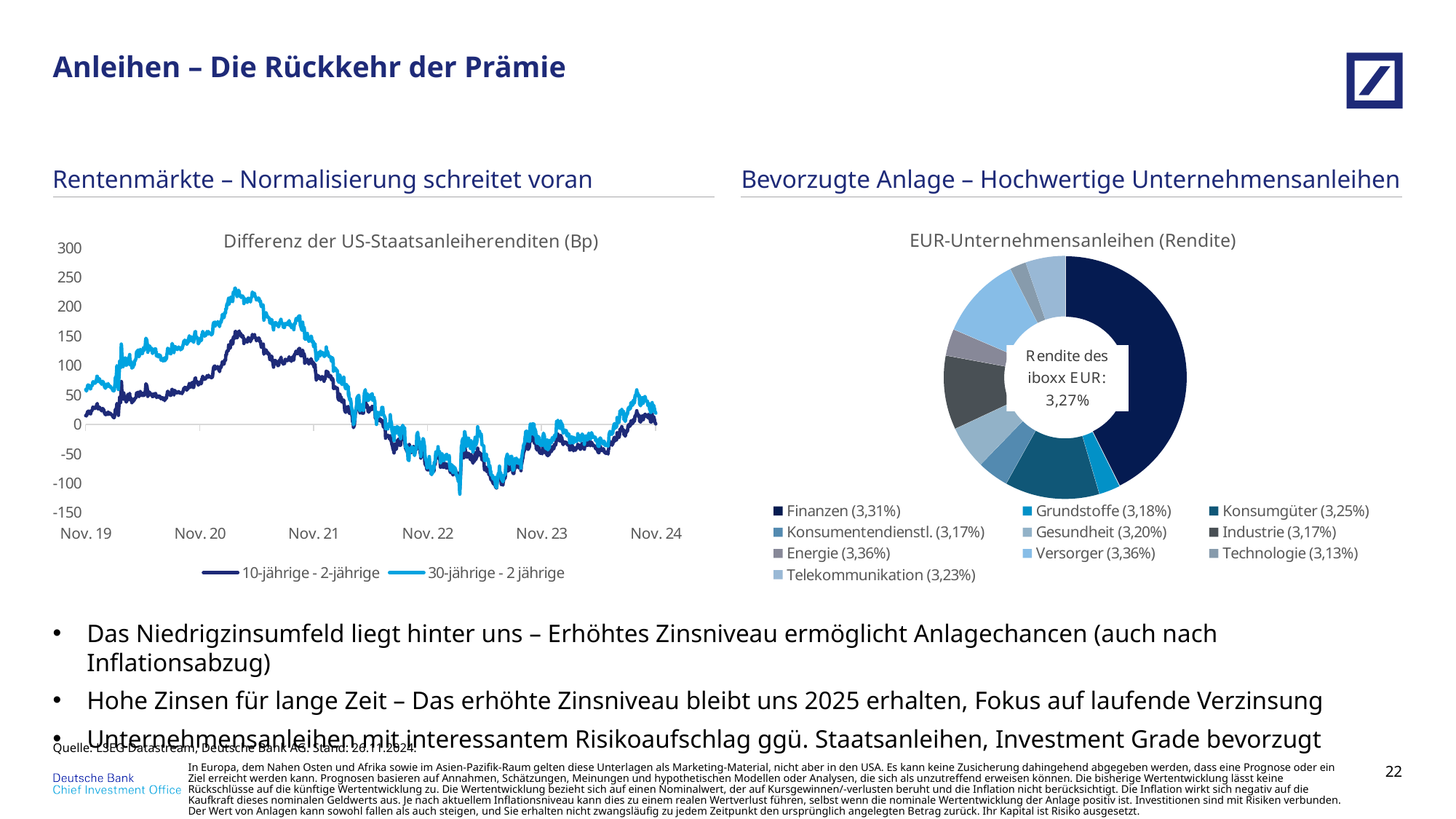
In the right chart 'EUR-Unternehmensanleihen (Rendite)', what is the yield shown for Finanzen? 3,31% In the right chart 'EUR-Unternehmensanleihen (Rendite)', what is the 'Rendite des iboxx EUR' shown in the centre of the doughnut? 3,27% In the right chart 'EUR-Unternehmensanleihen (Rendite)', which has the higher yield, Konsumgüter or Grundstoffe? Konsumgüter In the right chart 'EUR-Unternehmensanleihen (Rendite)', what is the yield shown for Gesundheit? 3,20% What kind of chart is the right chart titled 'EUR-Unternehmensanleihen (Rendite)'? doughnut chart In the left chart 'Differenz der US-Staatsanleiherenditen (Bp)', is the peak value of the '30-jährige - 2 jährige' series greater or less than 200? greater In the left chart 'Differenz der US-Staatsanleiherenditen (Bp)', does the '10-jährige - 2-jährige' series rise or fall between Nov. 20 and Nov. 22? fall In the right chart 'EUR-Unternehmensanleihen (Rendite)', which category has the lowest yield? Technologie (3,13%) In the left chart 'Differenz der US-Staatsanleiherenditen (Bp)', is the value of the '10-jährige - 2-jährige' series at Nov. 19 greater or less than 50? less What kind of chart is the left chart titled 'Differenz der US-Staatsanleiherenditen (Bp)'? line chart How many series does the legend of the left chart 'Differenz der US-Staatsanleiherenditen (Bp)' list? 2 How many categories does the legend of the right chart 'EUR-Unternehmensanleihen (Rendite)' list? 10